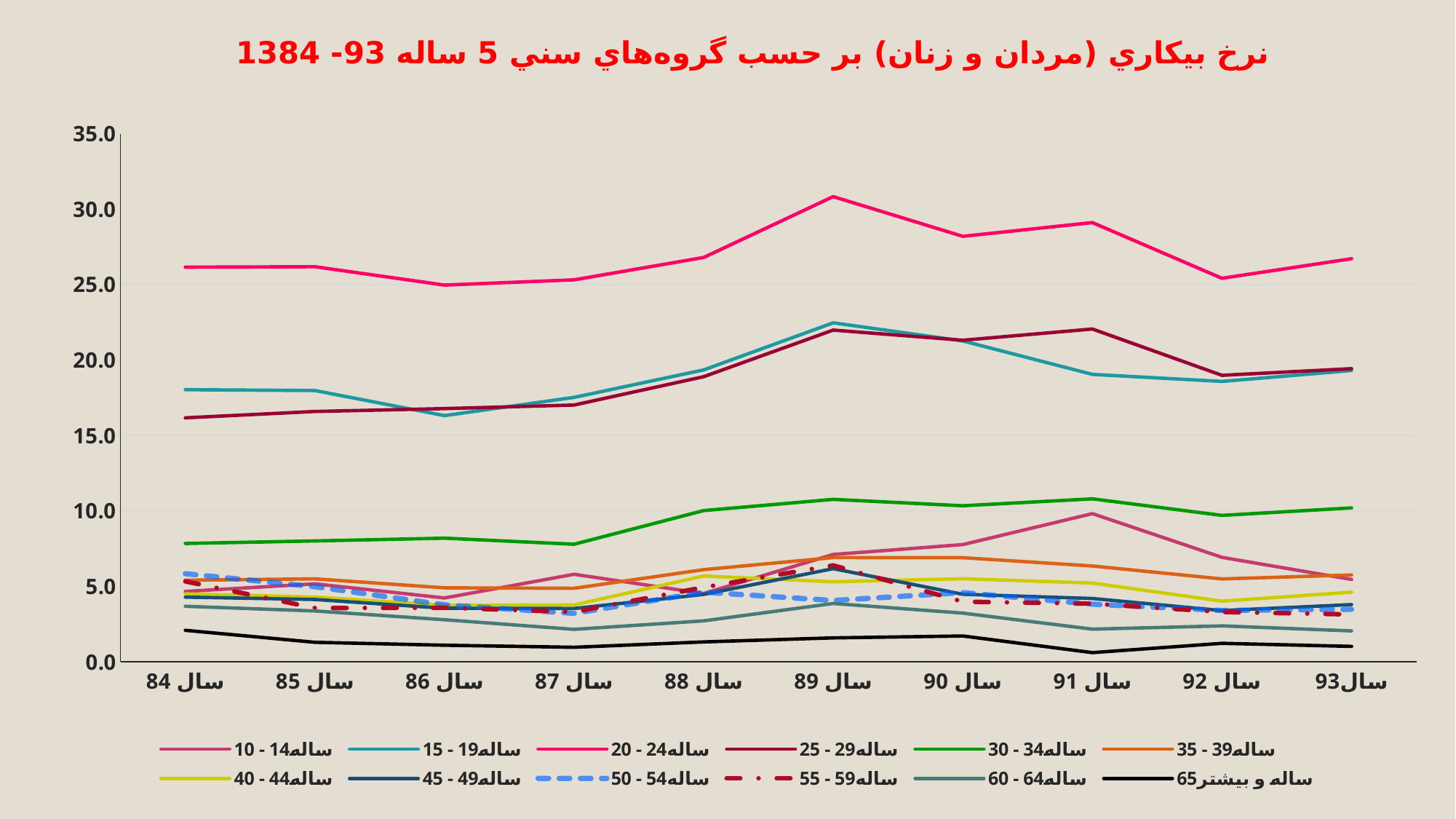
Does the 20 - 24 ساله series rise or fall from سال 86 to سال 89? rise Which age group has the lowest unemployment rate across all years shown? 65 ساله و بیشتر Which age-group series is drawn with a dashed blue line? 50 - 54 ساله Which age group has the highest unemployment rate across all years shown? 20 - 24 ساله How many age-group series does the legend list? 12 In which year does the 20 - 24 ساله series reach its highest value? سال 89 Is the value for 20 - 24 ساله in سال 89 greater or less than 30.0? greater What kind of chart is shown on the slide? line chart Is the value for 20 - 24 ساله in سال 84 greater or less than 25.0? greater How many years are shown along the x axis of the chart? 10 Is the value for 65 ساله و بیشتر in سال 91 greater or less than 5.0? less In سال 91, which is larger: the value for 30 - 34 ساله or the value for 35 - 39 ساله? 30 - 34 ساله